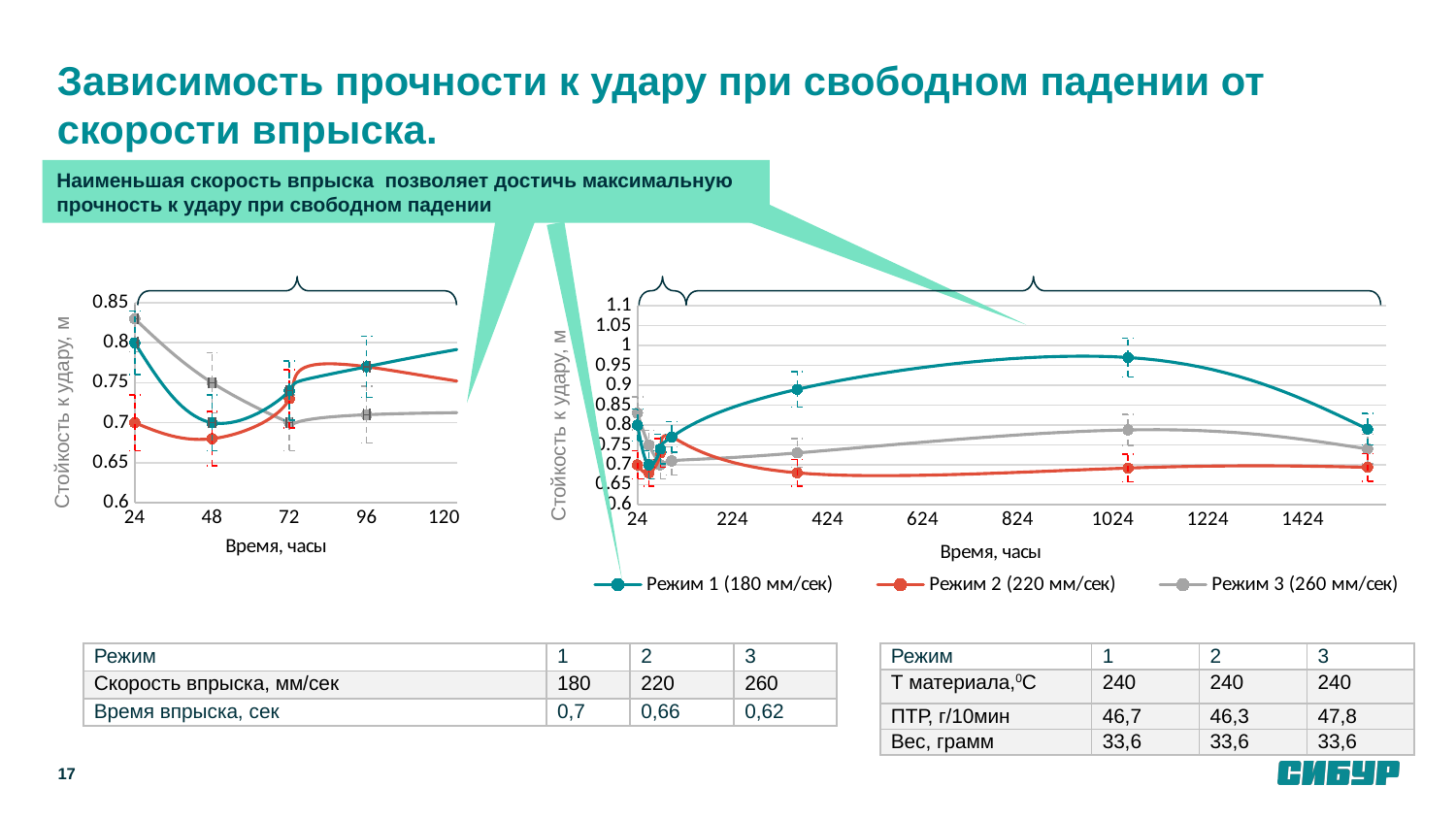
On the left chart, is the value for Режим 3 (260 мм/сек) at 24 hours greater or less than 0.8? greater How many tick labels are shown on the x axis of the left chart? 5 On the left chart, is the value for Режим 1 (180 мм/сек) at 48 hours greater or less than 0.75? less How many series does the legend of the right chart list? 3 On the right chart, is the value for Режим 1 (180 мм/сек) at around 1024 hours greater or less than 0.9? greater On the left chart, does the value for Режим 3 (260 мм/сек) rise or fall from 24 to 72 hours? fall On the right chart, which series is highest at around 1024 hours? Режим 1 (180 мм/сек) On the right chart, which series is lowest at around 1024 hours? Режим 2 (220 мм/сек) On the right chart, at around 1024 hours, which is larger: Режим 1 (180 мм/сек) or Режим 2 (220 мм/сек)? Режим 1 (180 мм/сек) What kind of chart is the chart on the right of the slide? line chart What is the x-axis title of the right chart? Время, часы